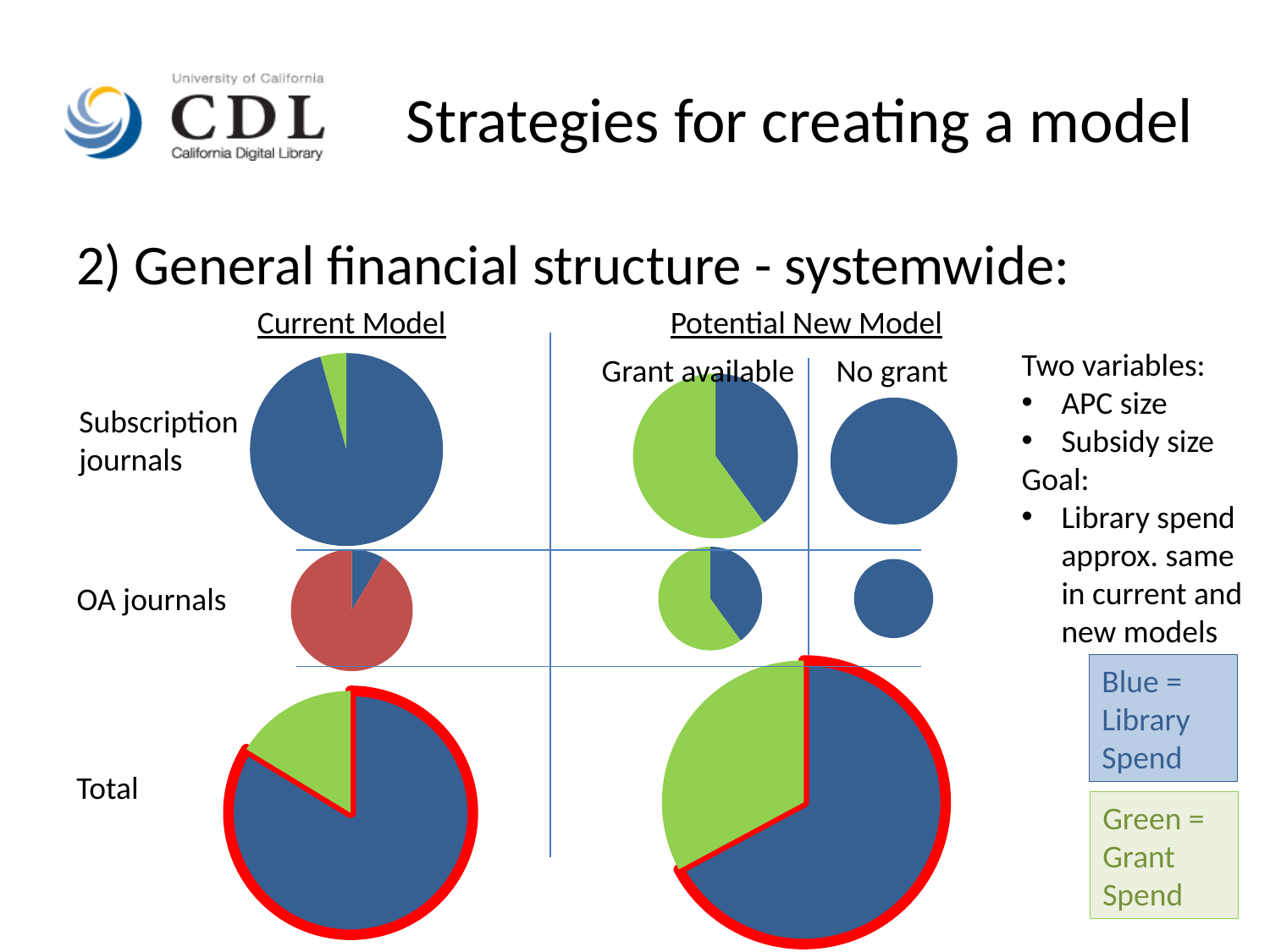
How many row categories (journal types/total) are the pie charts organised into? 3 How many pie charts are shown on the slide in total? 8 According to the legend boxes, what does the blue colour in the pie charts represent? Library Spend In the Potential New Model 'Grant available' pie for OA journals, which slice is larger, green or blue? Green According to the legend boxes, what does the green colour in the pie charts represent? Grant Spend In the Current Model pie for Subscription journals, which slice is larger, the blue slice or the green slice? Blue In the Potential New Model 'Grant available' pie for Subscription journals, which slice is larger, green or blue? Green What kind of charts are used on the slide to show the financial structure? Pie charts In the Potential New Model 'No grant' pie for Subscription journals, what share of the pie is blue (Library Spend)? All of it (100%)